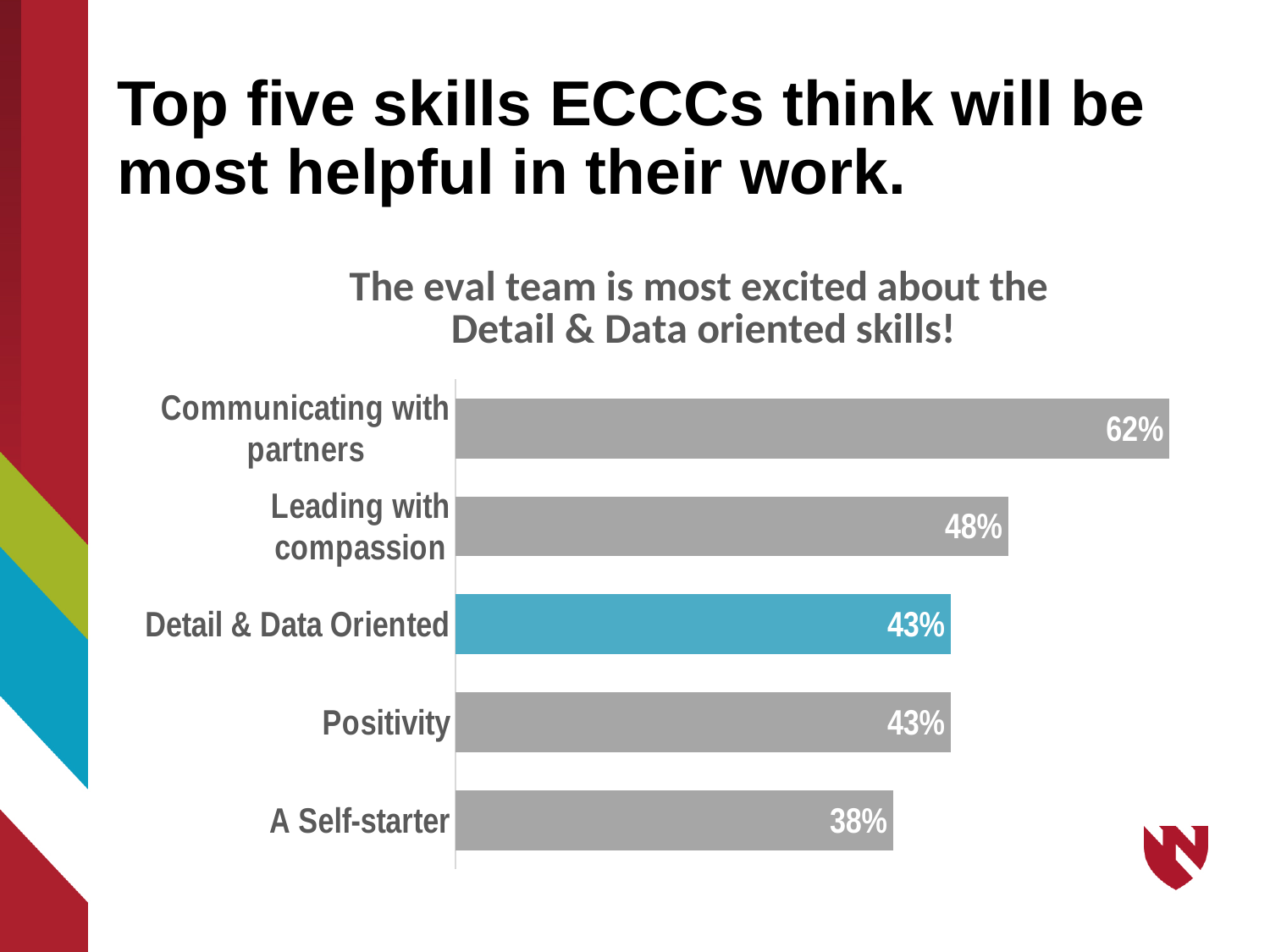
What is the difference between the percentages for Communicating with partners and Leading with compassion? 14% What kind of chart is shown on the slide? Bar chart Which skill has the lowest percentage? A Self-starter What percentage is shown for Leading with compassion? 48% Which skill has the highest percentage? Communicating with partners What percentage is shown for A Self-starter? 38% What percentage is shown for Communicating with partners? 62% How many skills are shown in the chart? 5 Which is larger, the value for Leading with compassion or the value for Positivity? Leading with compassion Which bar is highlighted in blue rather than grey? Detail & Data Oriented What percentage is shown for Detail & Data Oriented? 43% What is the difference between the percentages for Positivity and A Self-starter? 5%